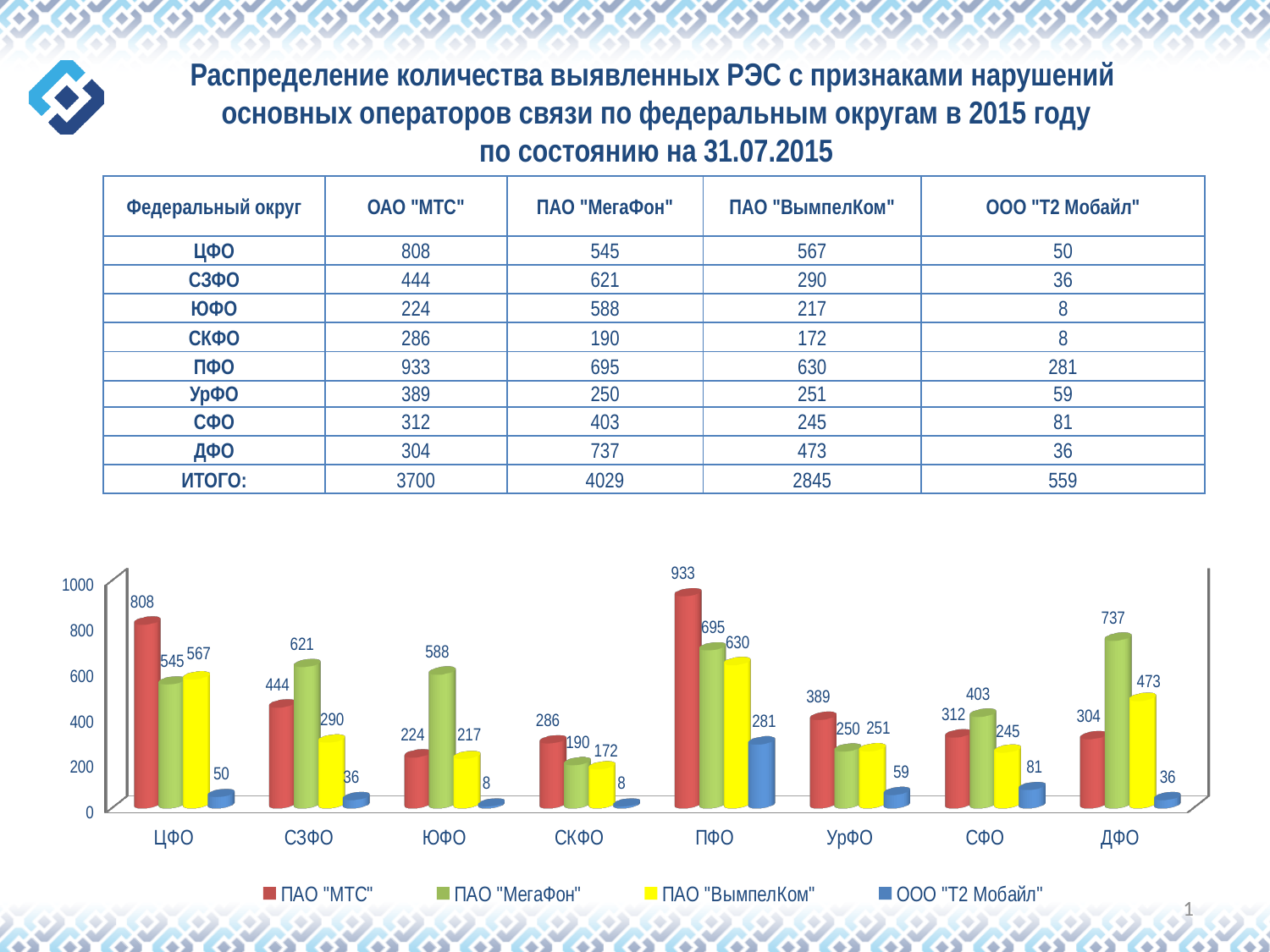
Which is larger in СЗФО: ПАО "МТС" or ПАО "МегаФон"? ПАО "МегаФон" What is the value for ПАО "МТС" in ПФО? 933 What is the value for ПАО "МегаФон" in ДФО? 737 Which federal district has the highest value for ПАО "ВымпелКом"? ПФО How many federal districts are shown on the x axis of the chart? 8 What is the difference between ПАО "МегаФон" and ПАО "ВымпелКом" in ЮФО? 371 What is the difference between ПАО "МТС" and ПАО "МегаФон" in ЦФО? 263 Which colour represents ООО "Т2 Мобайл" in the chart? blue What type of chart is shown on the slide? bar chart What is the value for ООО "Т2 Мобайл" in ЦФО? 50 Which federal district has the lowest value for ПАО "МТС"? ЮФО How many series does the chart legend list? 4